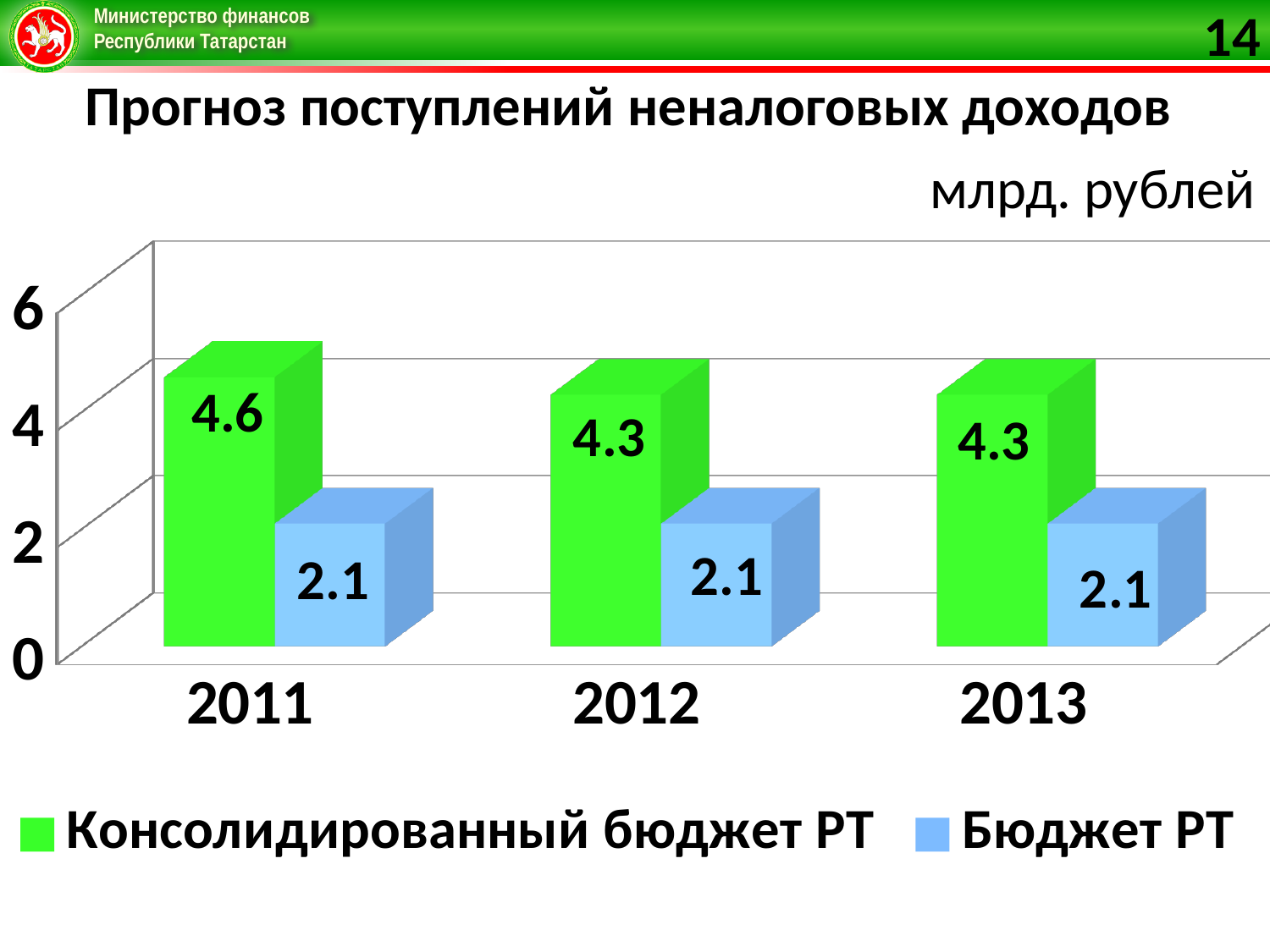
How many series does the legend list? 2 What is the value for Бюджет РТ in 2013? 2.1 Does the Консолидированный бюджет РТ value rise or fall from 2011 to 2012? fall What kind of chart is shown on the slide? bar chart What is the difference between Консолидированный бюджет РТ and Бюджет РТ in 2013? 2.2 How many years are shown on the x axis? 3 What unit is stated above the chart? млрд. рублей What is the difference between Консолидированный бюджет РТ and Бюджет РТ in 2011? 2.5 In which year is the Консолидированный бюджет РТ value highest? 2011 What is the value for Консолидированный бюджет РТ in 2012? 4.3 Which is larger in 2012: Консолидированный бюджет РТ or Бюджет РТ? Консолидированный бюджет РТ What is the value for Консолидированный бюджет РТ in 2011? 4.6